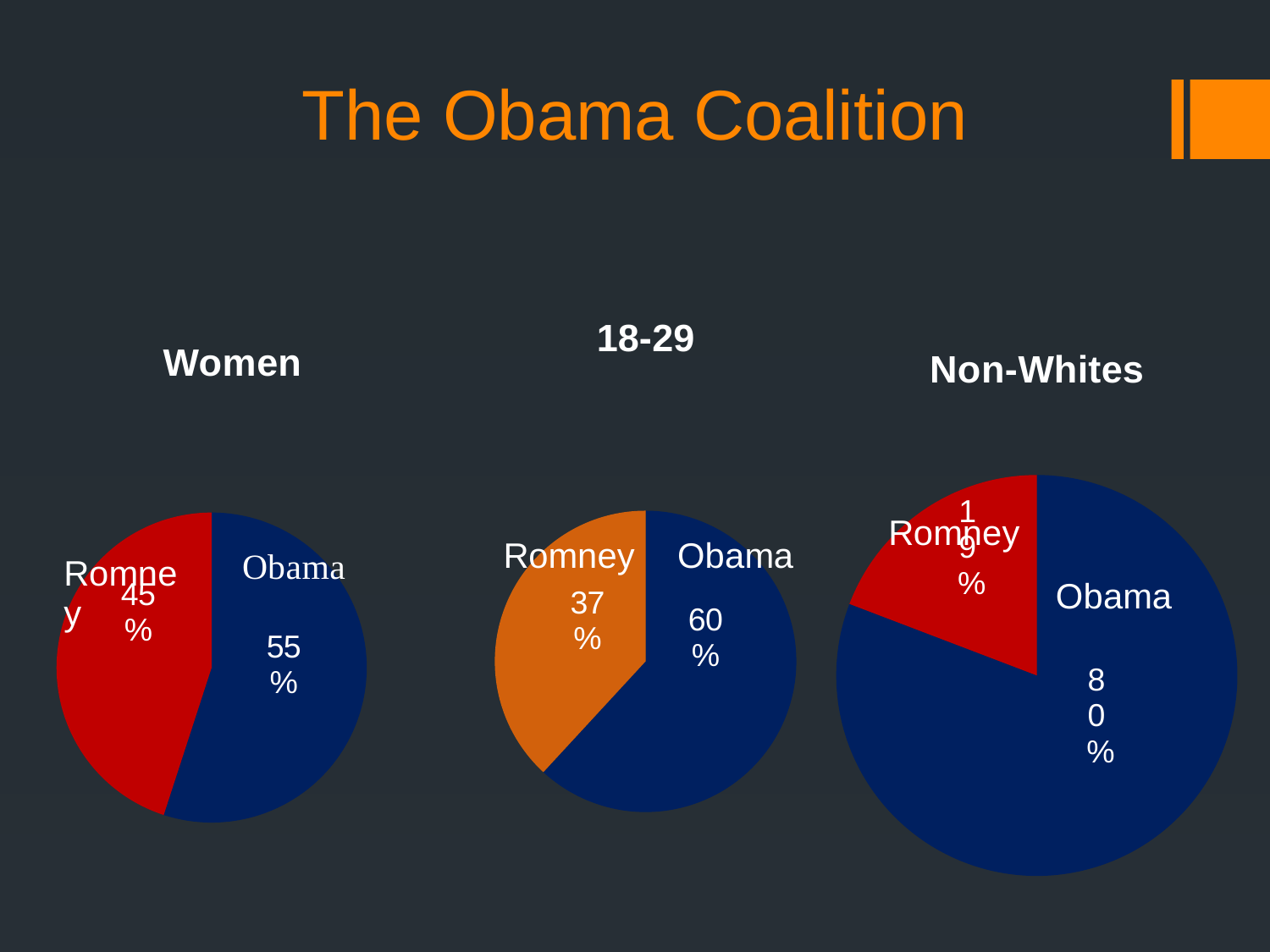
How many pie charts are shown on the slide? 3 In the Non-Whites pie chart, what share of the vote did Obama receive? 80% What type of chart is used for the Non-Whites group? Pie chart In the Non-Whites pie chart, which candidate has the smaller slice? Romney In the Women pie chart, which candidate has the larger slice? Obama In the 18-29 pie chart, what is the difference between Obama's and Romney's shares? 23% In the Women pie chart, what share of the vote did Romney receive? 45% In the 18-29 pie chart, what share of the vote did Romney receive? 37% In the Women pie chart, what is the difference between Obama's and Romney's shares? 10% In the Non-Whites pie chart, what share of the vote did Romney receive? 19% In the 18-29 pie chart, what share of the vote did Obama receive? 60% In the Women pie chart, what share of the vote did Obama receive? 55%